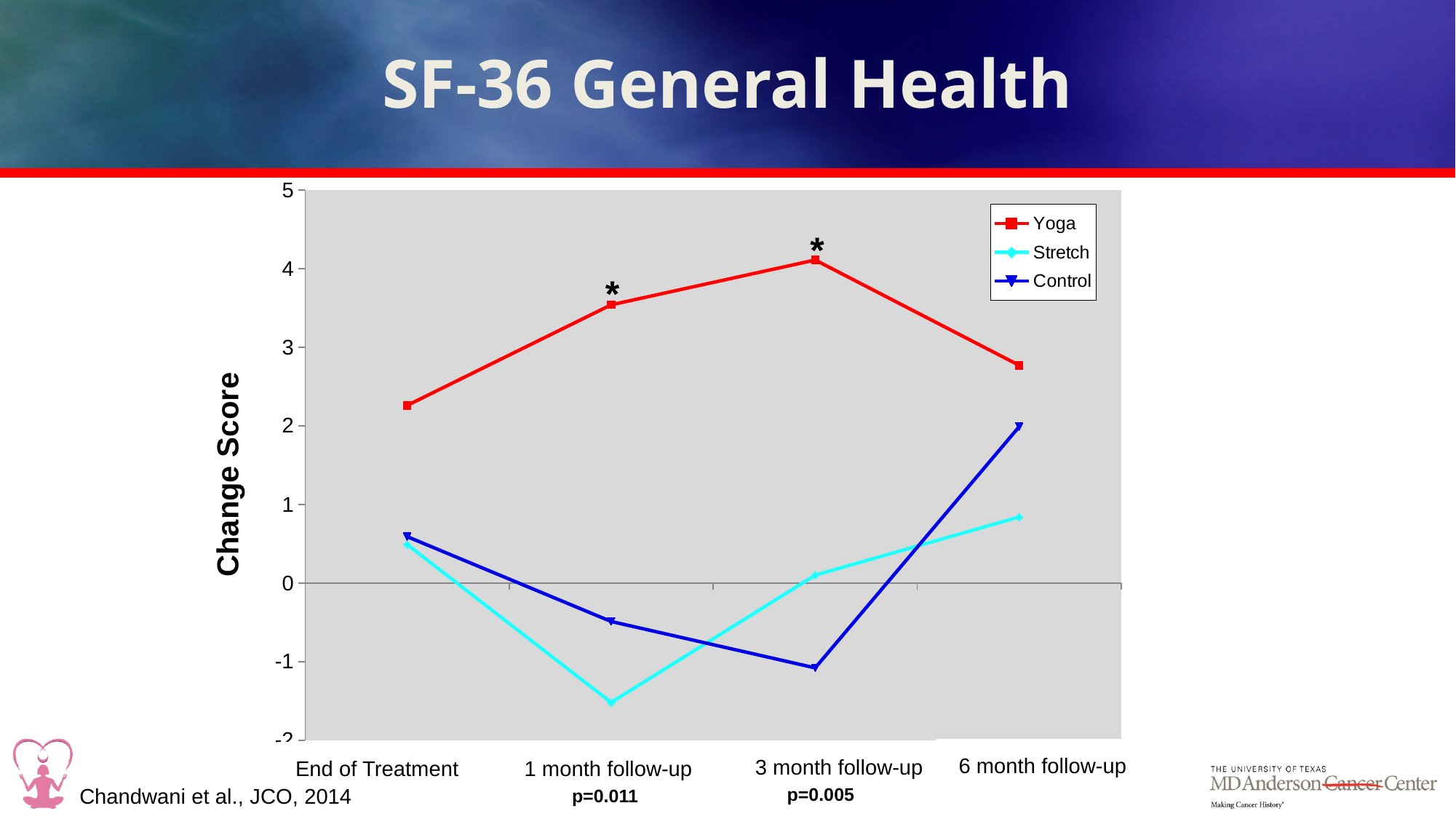
What is the label on the y axis? Change Score At 3 month follow-up, which has the larger change score, Stretch or Control? Stretch At which time point does the Control series reach its lowest change score? 3 month follow-up At 6 month follow-up, which has the larger change score, Control or Stretch? Control How many series does the legend list? 3 At which time point does the Yoga series reach its highest change score? 3 month follow-up How many time points are plotted along the x axis? 4 What kind of chart is shown on the slide? line chart At which time point does the Stretch series reach its lowest change score? 1 month follow-up Is the Stretch value at 1 month follow-up greater or less than -1? less Is the Yoga value at 1 month follow-up greater or less than 3? greater Does the Yoga series rise or fall from 3 month follow-up to 6 month follow-up? fall